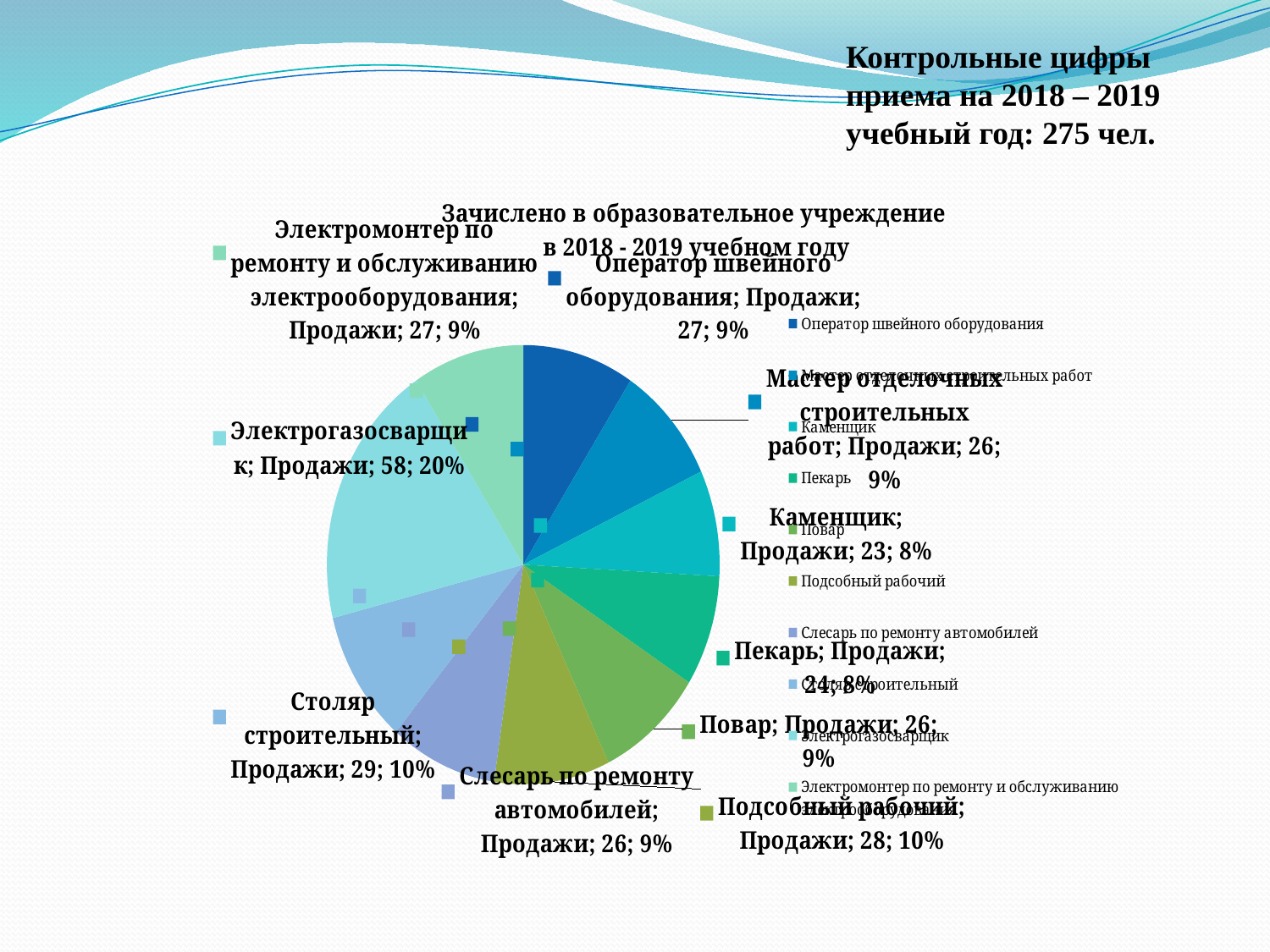
Which category has the largest slice? Электрогазосварщик What is the value for Подсобный рабочий? 28 How many slices does the pie chart have? 10 What is the difference between the values for Электрогазосварщик and Каменщик? 35 What is the title of the chart? Зачислено в образовательное учреждение в 2018 - 2019 учебном году Which category has the smallest slice? Каменщик How many entries does the legend list? 10 What is the value for Электрогазосварщик? 58 What type of chart is shown on the slide? pie chart What is the value for Каменщик? 23 What share of the pie does Электрогазосварщик represent? 20% Which is larger, the value for Столяр строительный or the value for Пекарь? Столяр строительный